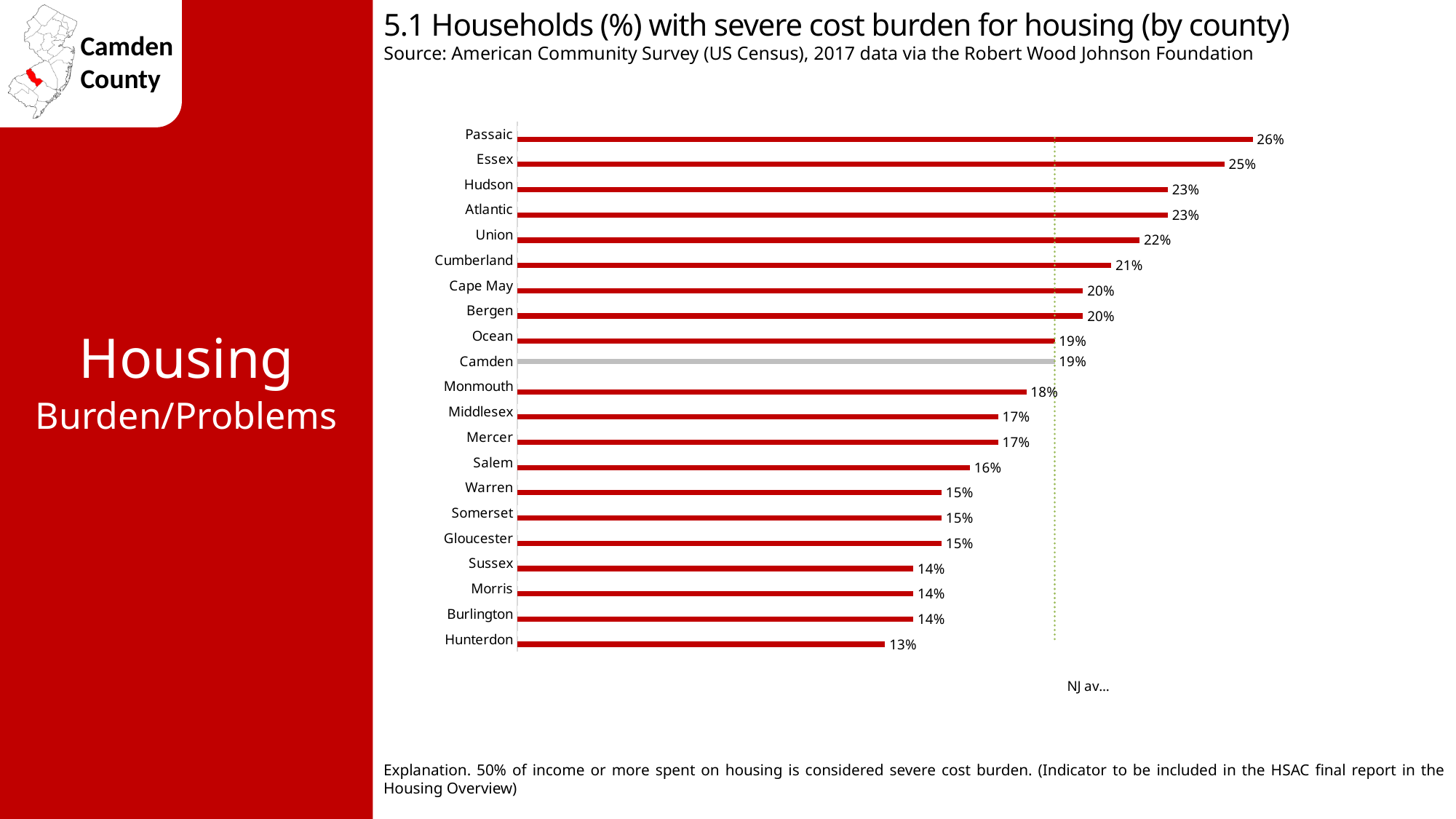
What percentage of households in Camden County have a severe housing cost burden? 19% How many counties are shown in the chart? 21 What is the value shown for Cumberland? 21% Which has a higher value, Union or Salem? Union What is the difference between the values for Essex and Camden? 6% Which county's bar is shown in grey rather than red? Camden Which county has the lowest percentage of households with severe cost burden? Hunterdon What is the value shown for Hunterdon? 13% Which county has the highest percentage of households with severe cost burden? Passaic What is the difference between the values for Passaic and Hunterdon? 13% What type of chart is shown on the slide? Bar chart What is the value shown for Passaic? 26%